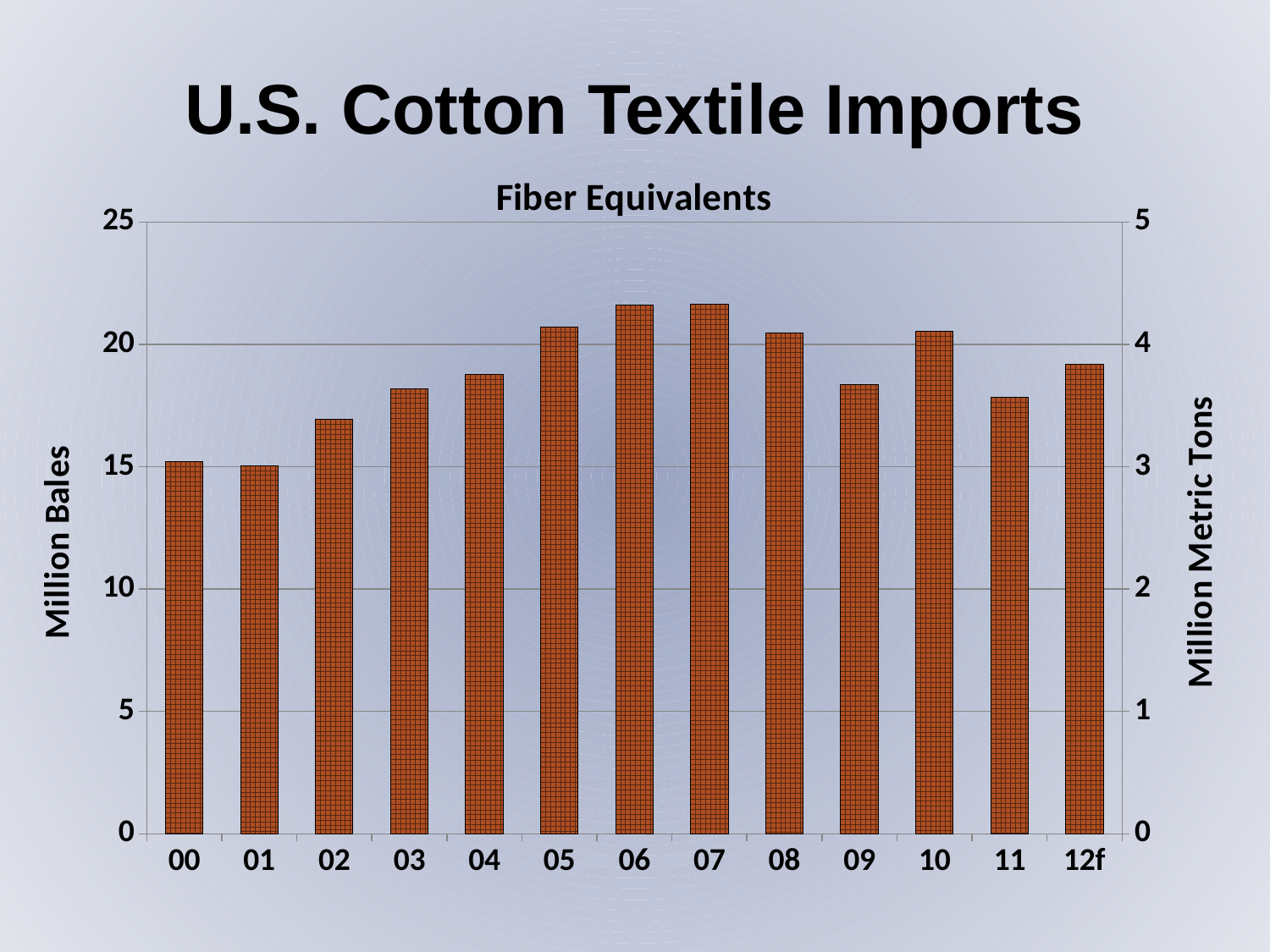
What is the label on the left vertical axis? Million Bales How many years (categories) are plotted on the x axis? 13 Do the values rise or fall from 00 to 07? rise Is the value for 12f greater or less than 20 million bales? less Is the value for 02 greater or less than 20 million bales? less Which year has the larger value, 10 or 11? 10 What kind of chart is shown on the slide? bar chart Which year has the larger value, 05 or 02? 05 Is the value for 11 greater or less than 20 million bales? less What is the label on the right vertical axis? Million Metric Tons